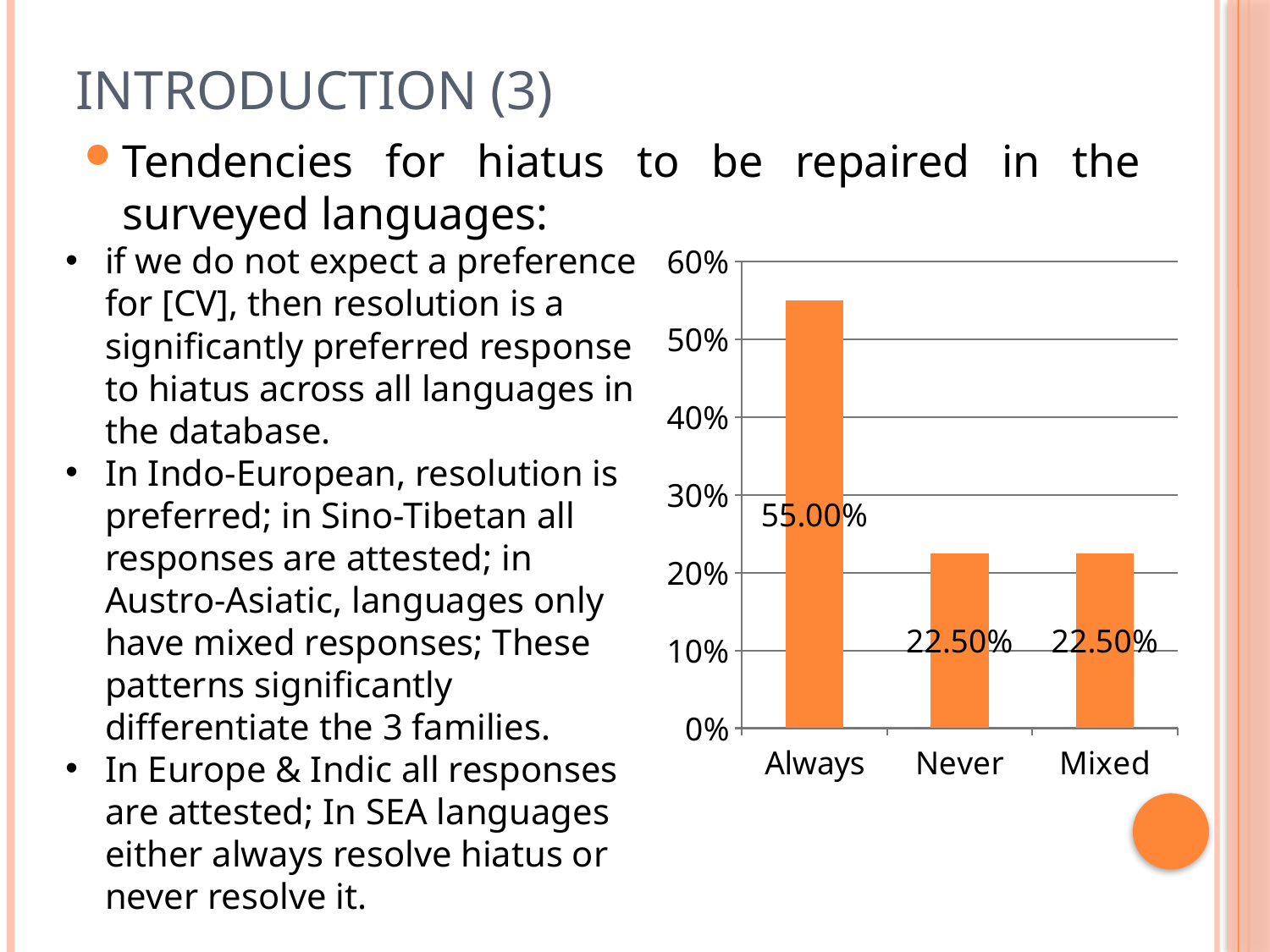
What is the value for Always? 55.00% What is the difference between the values for Always and Never? 32.50% Is the value for Never greater or less than 30%? less What is the value for Never? 22.50% What kind of chart is shown on the slide? bar chart Which is larger, the value for Always or the value for Mixed? Always What is the highest value shown on the y axis? 60% What is the value for Mixed? 22.50% How many categories are shown on the x axis? 3 What colour are the bars in the chart? orange Is the value for Always greater or less than 50%? greater Which category has the highest value? Always